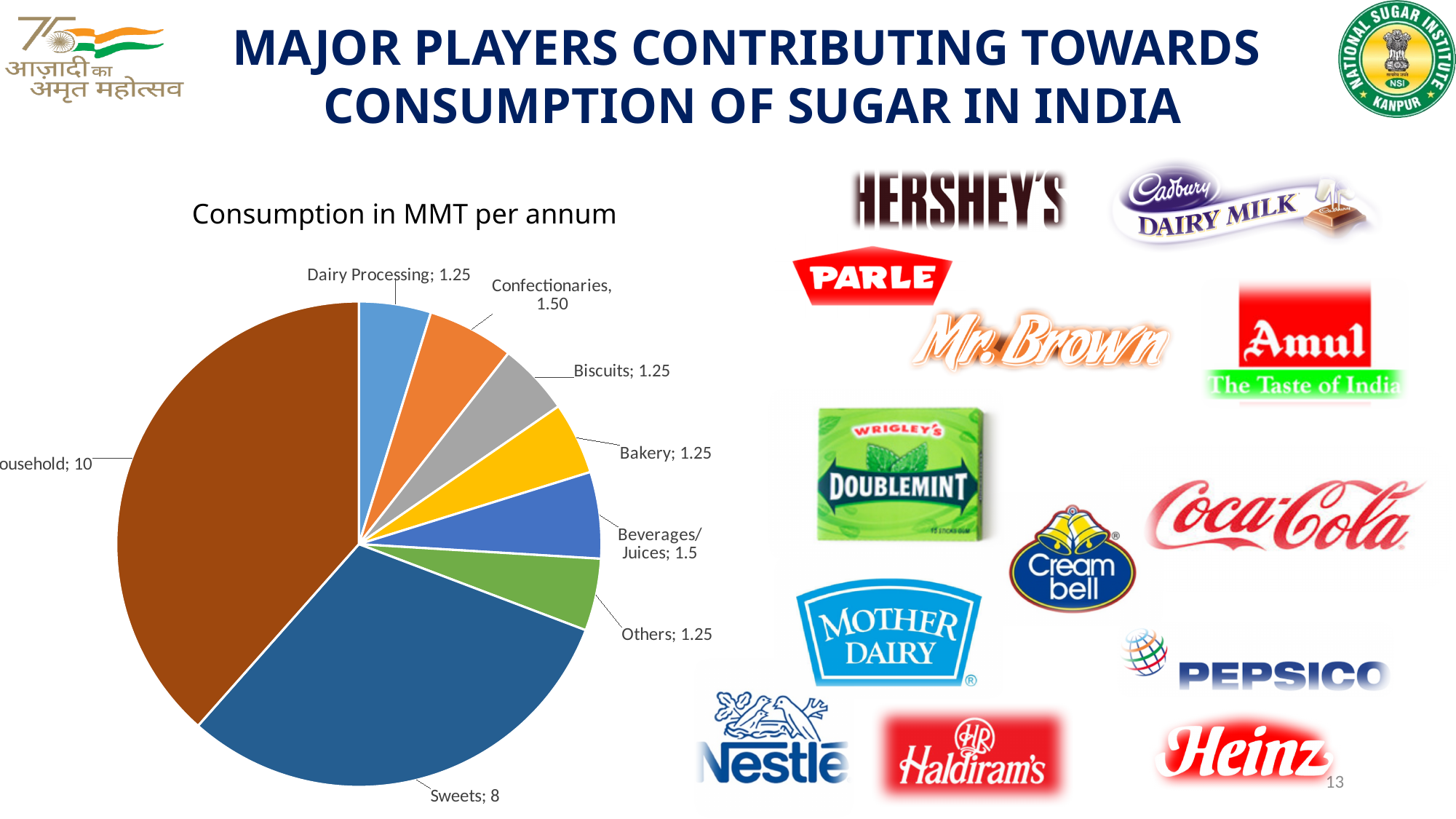
Which is larger, the value for Dairy Processing or the value for Confectionaries? Confectionaries What is the title of the pie chart? Consumption in MMT per annum Which is larger, the value for Sweets or the value for Household? Household What is the difference between the Confectionaries value and the Biscuits value? 0.25 What is the difference between the Household value and the Sweets value? 2 What is the consumption value for Confectionaries? 1.50 What is the consumption value for Beverages/Juices? 1.5 What is the consumption value for Sweets? 8 How many categories are shown in the pie chart? 8 What kind of chart is shown on the slide? pie chart What is the consumption value for Bakery? 1.25 Which category has the largest slice of the pie? Household